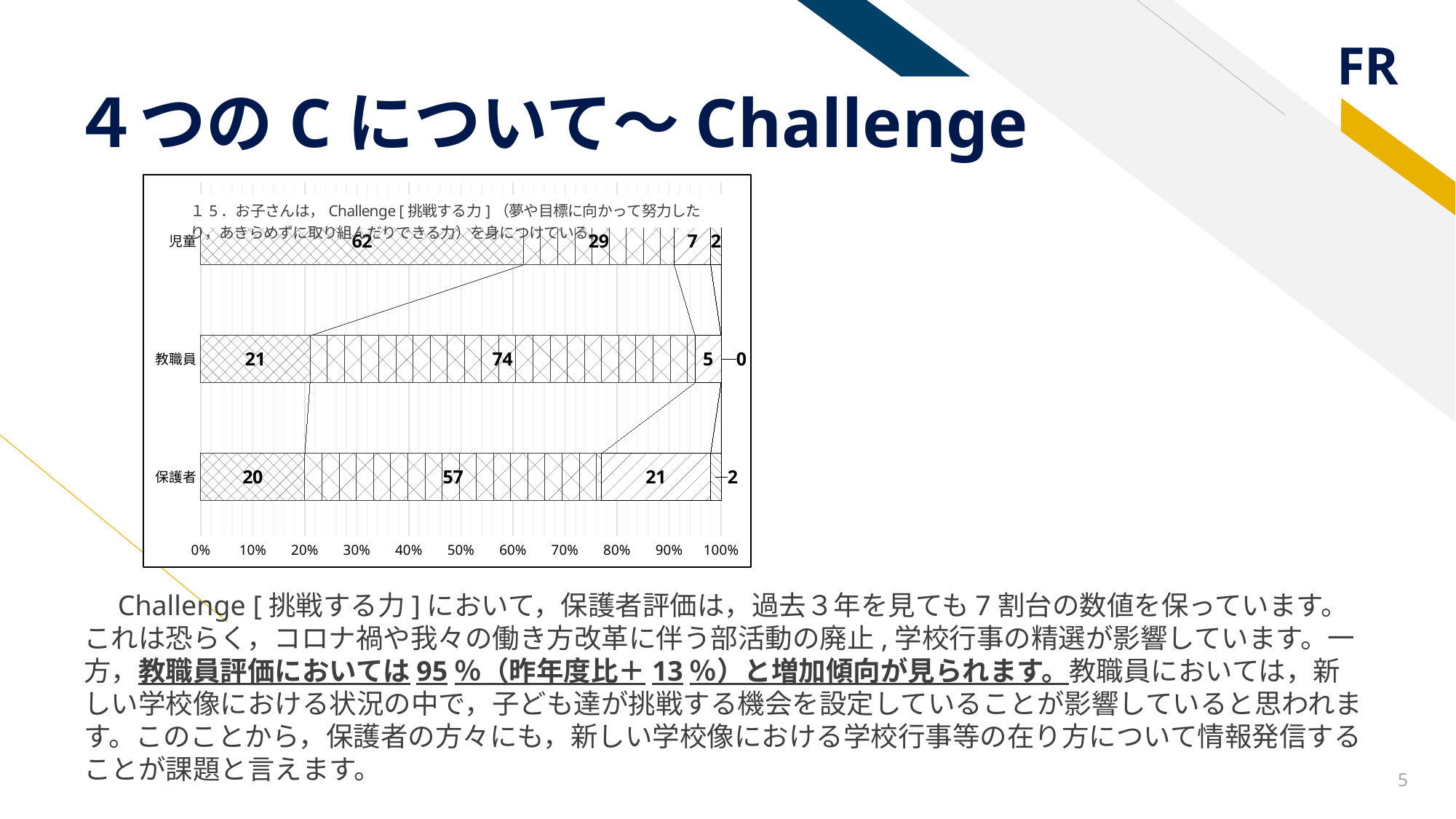
What is the value of the last (rightmost) segment of the 教職員 bar? 0 Which is larger: the second segment of 教職員 or the second segment of 保護者? 教職員 Which category has the largest leftmost segment? 児童 What is the combined value of the first two segments of the 教職員 bar? 95 What is the value of the leftmost segment of the 児童 bar? 62 What is the maximum value shown on the x axis of the chart? 100% What is the difference between the leftmost segment of 児童 and the leftmost segment of 保護者? 42 What is the value of the third segment of the 保護者 bar? 21 What kind of chart is shown on the slide? Stacked horizontal bar chart What is the value of the second segment of the 教職員 bar? 74 Which category has the smallest second segment? 児童 How many categories (respondent groups) are plotted on the y axis of the chart? 3